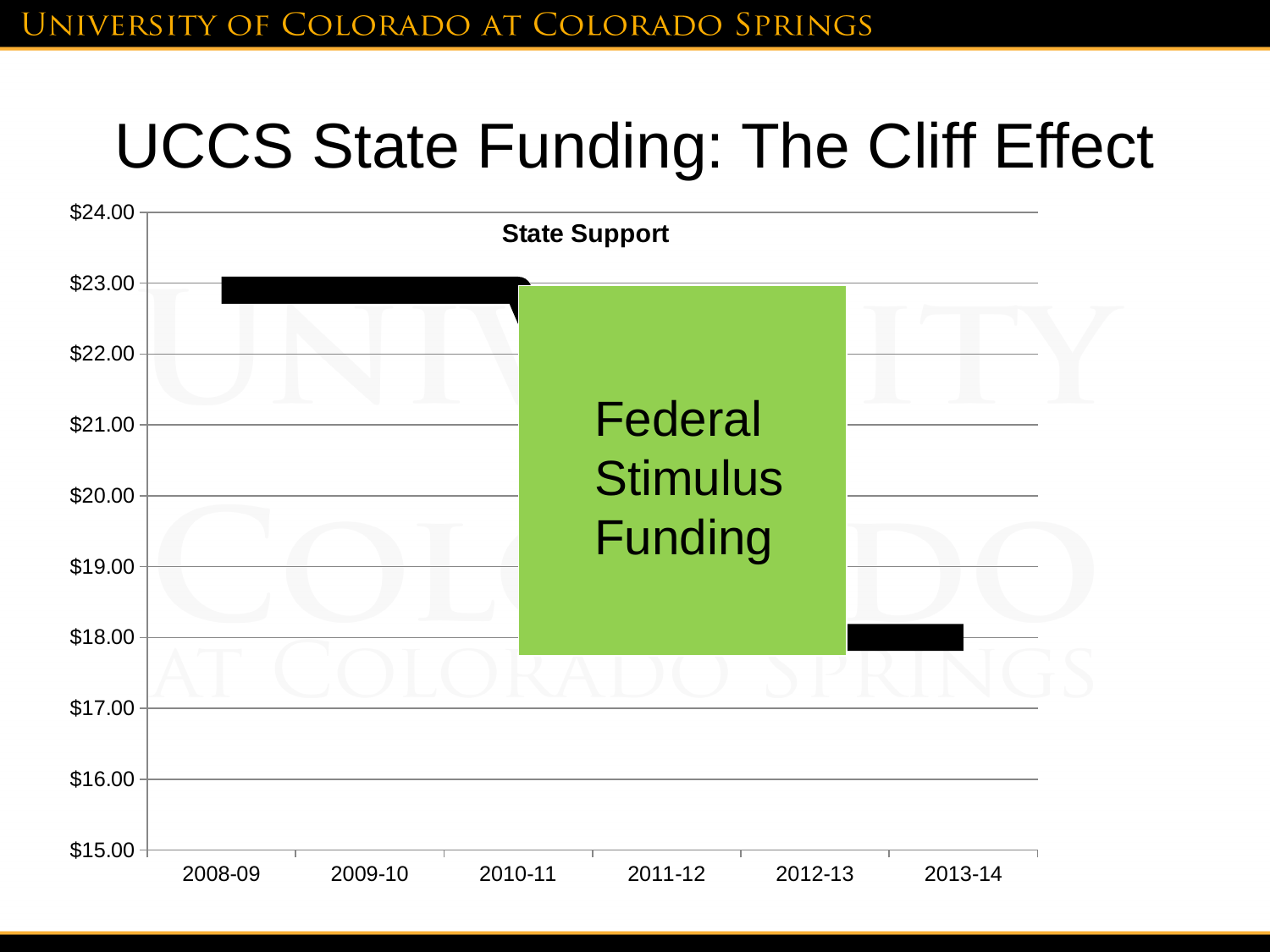
How many fiscal years are labelled on the x axis of the chart? 6 What is the highest value shown on the y axis of the chart? $24.00 Which year shows the lowest visible State Support value? 2013-14 Is the State Support value for 2013-14 greater or less than $17.00? greater What kind of chart is shown on the slide? line chart Is the State Support value for 2013-14 greater or less than $19.00? less Is the State Support value for 2008-09 greater or less than $22.00? greater What text is written in the green box covering the middle of the chart? Federal Stimulus Funding Does State Support rise or fall from 2008-09 to 2013-14? fall Which year has the larger State Support value, 2008-09 or 2013-14? 2008-09 What is the title of the chart? State Support